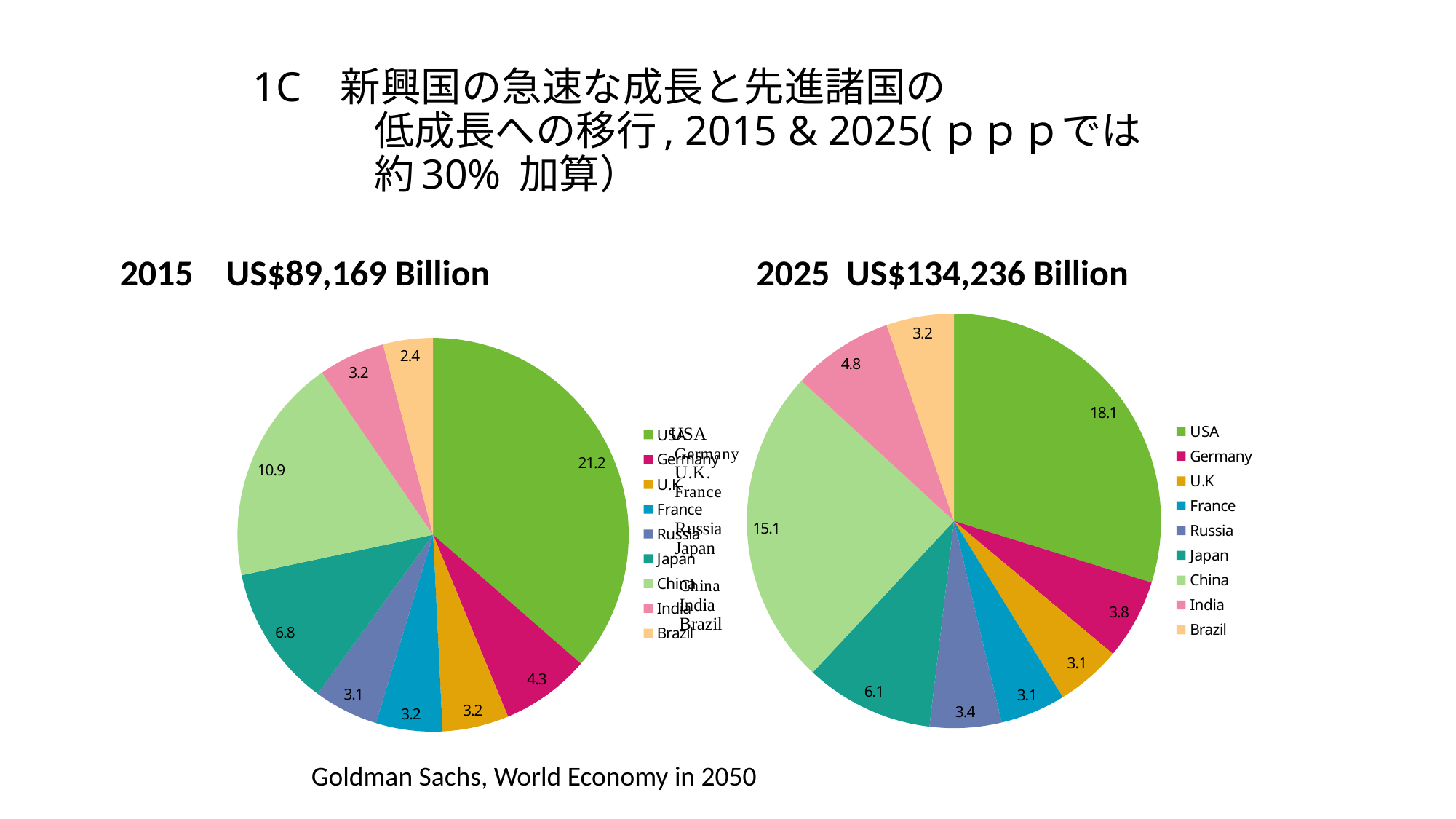
In the 2015 pie chart, what is the value for USA? 21.2 In the 2025 pie chart, what is the value for India? 4.8 How many countries are shown in the 2025 pie chart? 9 In the 2025 pie chart, what is the value for China? 15.1 In the 2015 pie chart, which is larger, the value for Germany or the value for Japan? Japan What type of chart is used on this slide? Pie chart How many entries does the legend of the 2015 pie chart list? 9 What total is shown in the title of the 2025 pie chart? US$134,236 Billion In the 2025 pie chart, which country has the largest slice? USA In the 2015 pie chart, which country has the smallest slice? Brazil In the 2025 pie chart, what is the difference between the USA value and the China value? 3.0 In the 2015 pie chart, what is the value for Japan? 6.8